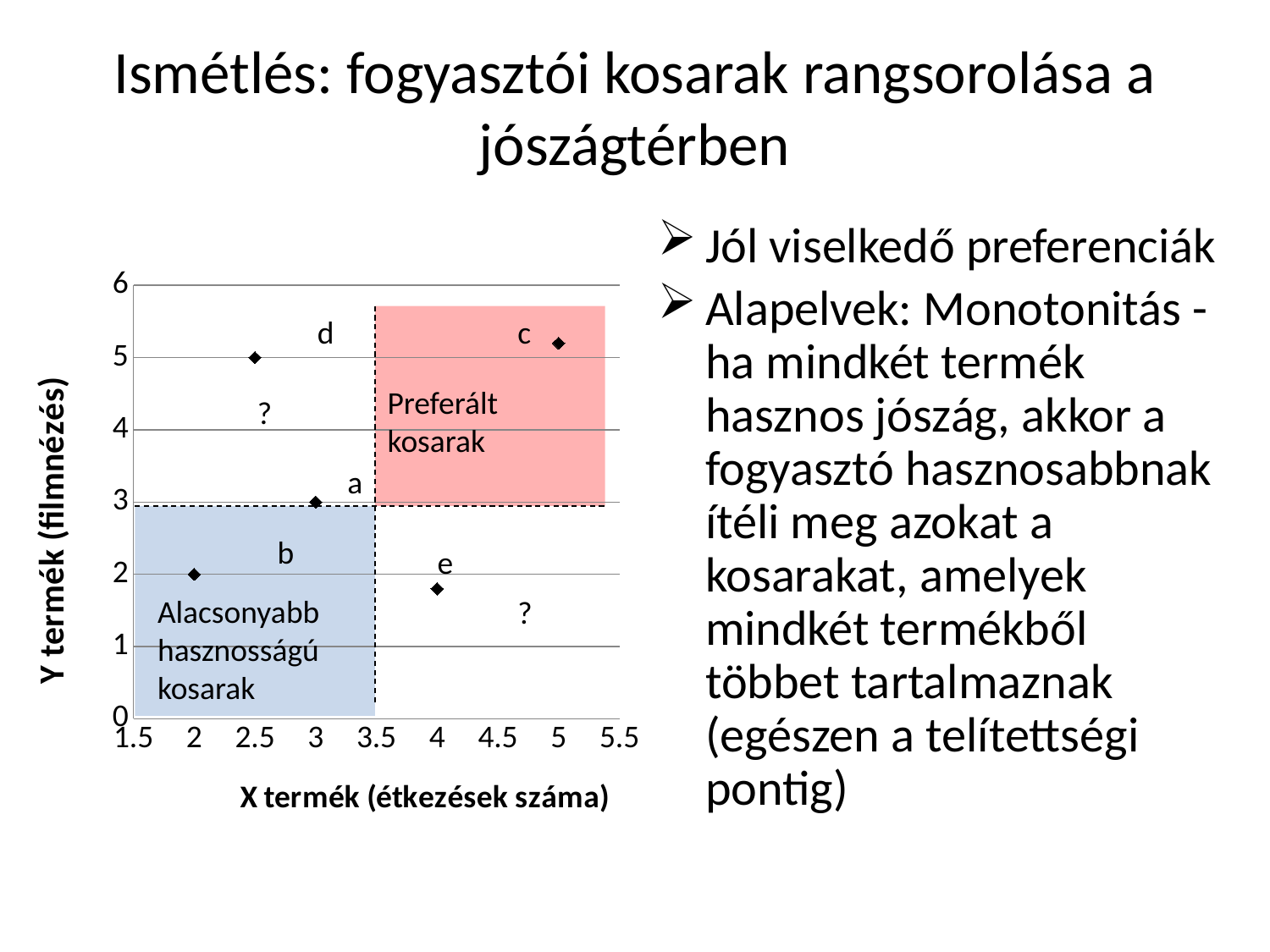
How many labelled points (baskets) are plotted on the chart? 5 Is the y value of point c greater or less than 4? greater Which point has a larger y value, d or b? d What kind of chart is shown on the slide? scatter chart What is the x value (X termék) of point d? 2.5 What is the title of the y axis of the chart? Y termék (filmnézés) What is the title of the x axis of the chart? X termék (étkezések száma) What is the y value (Y termék) of point d? 5 Which point has the lowest x value (X termék)? b What is the x value (X termék) of point b? 2 Which point has the highest x value (X termék)? c Is the y value of point e greater or less than 3? less